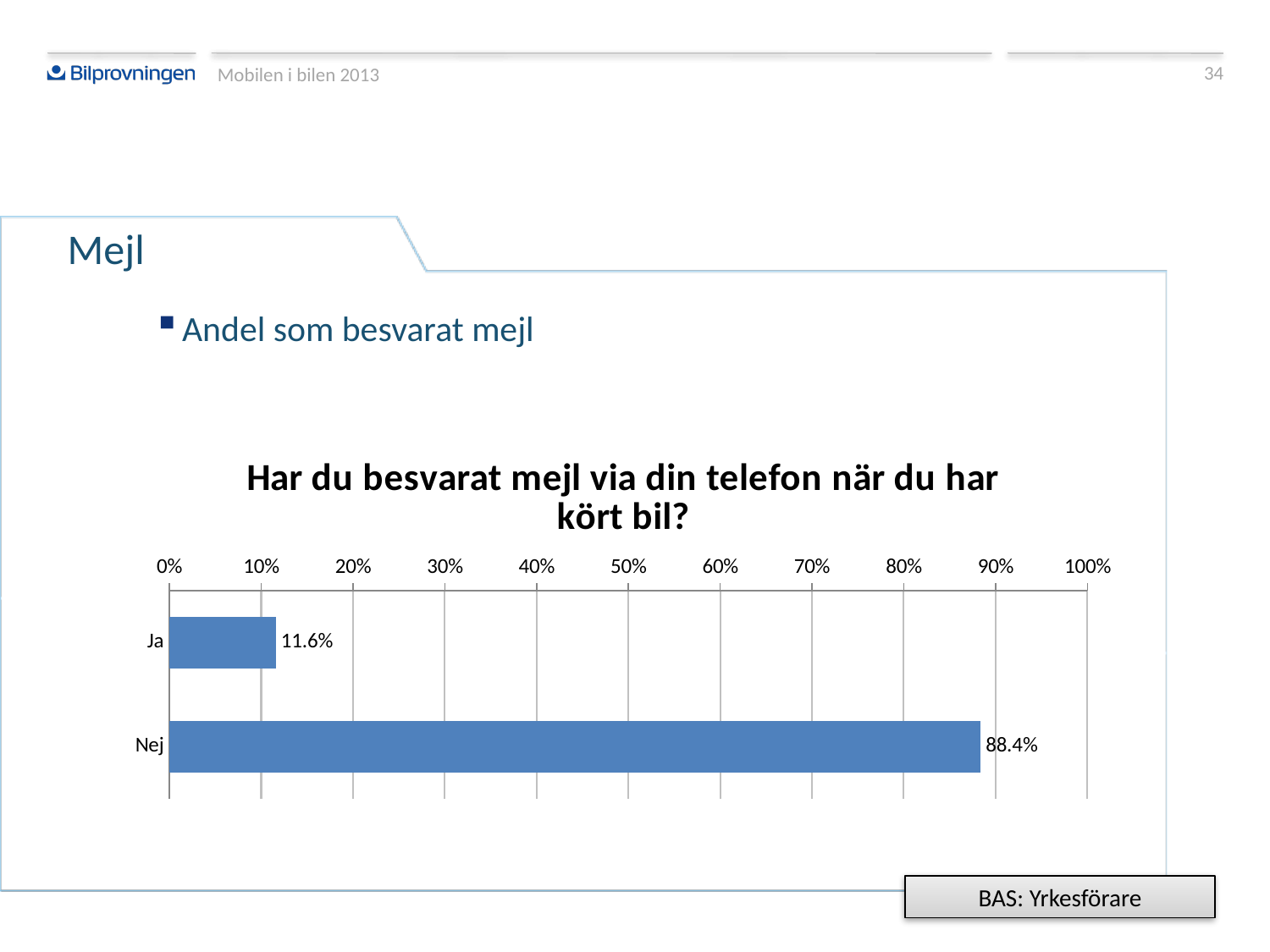
Which category has the lowest value? Ja What is the maximum value shown on the chart's axis? 100% Which category has the highest value? Nej Which is larger, the value for "Ja" or the value for "Nej"? Nej What kind of chart is shown on the slide? bar chart Is the value for "Ja" greater or less than 20%? less What is the difference between the values for "Nej" and "Ja"? 76.8% Is the value for "Nej" greater or less than 80%? greater How many categories are shown in the chart? 2 What is the value for "Ja"? 11.6% What is the value for "Nej"? 88.4% What is the title of the chart? Har du besvarat mejl via din telefon när du har kört bil?